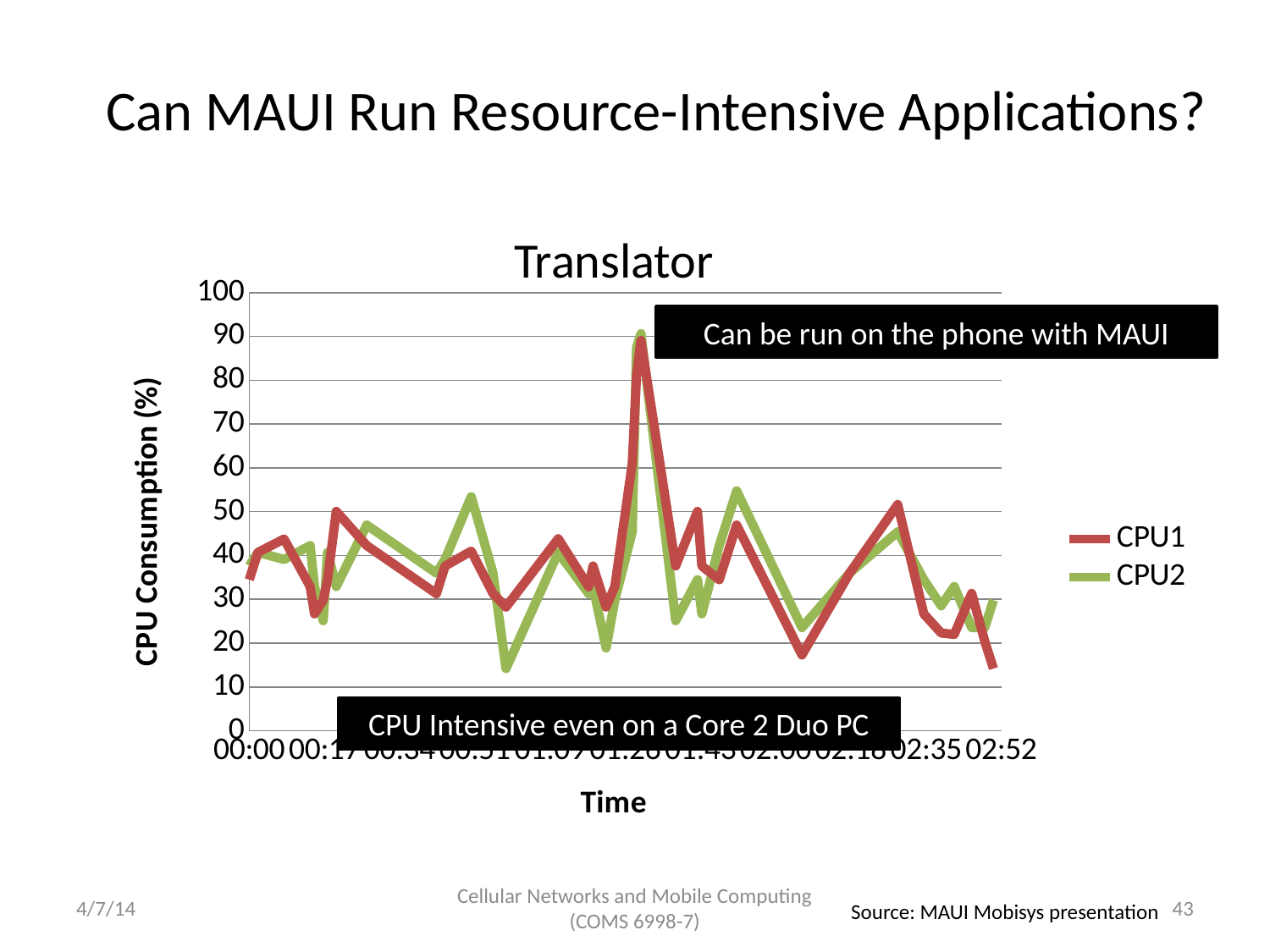
Is the peak value of the CPU2 series greater or less than 80? greater How many series does the legend list? 2 What are the names of the two series in the legend? CPU1 and CPU2 What kind of chart is shown on the slide? line chart Is the lowest value of the CPU2 series greater or less than 20? less How many time labels are shown along the x axis? 11 What is the label of the y axis? CPU Consumption (%) Is the peak value of the CPU1 series greater or less than 80? greater What is the title of the chart? Translator